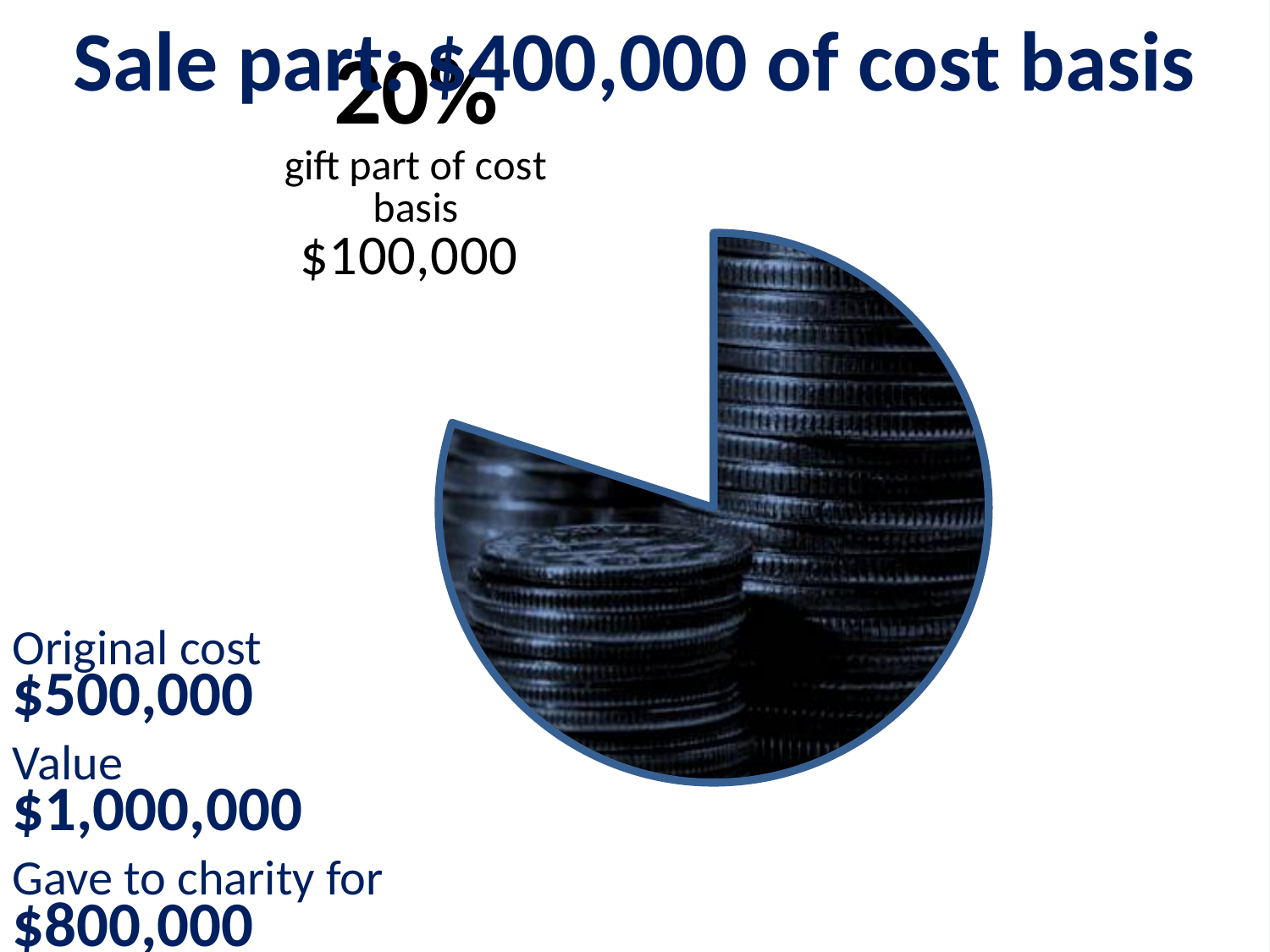
Is the share of the gift part of cost basis greater or less than 50%? less If the gift part is 20% of the pie, what share does the sale part represent? 80% What dollar amount is shown on the pie chart for the gift part of cost basis? $100,000 Which is larger, the sale part of cost basis or the gift part of cost basis? sale part What is the title of the chart on the slide? Sale part: $400,000 of cost basis What kind of chart is shown on the slide? pie chart What is the difference between the sale part ($400,000) and the gift part ($100,000) of cost basis? $300,000 What image fills the pie chart slice? stacks of coins According to the chart title, how much of the cost basis is the sale part? $400,000 What is the total cost basis when the sale part ($400,000) and the gift part ($100,000) are added together? $500,000 What percentage is labelled on the pie chart for the gift part of cost basis? 20%